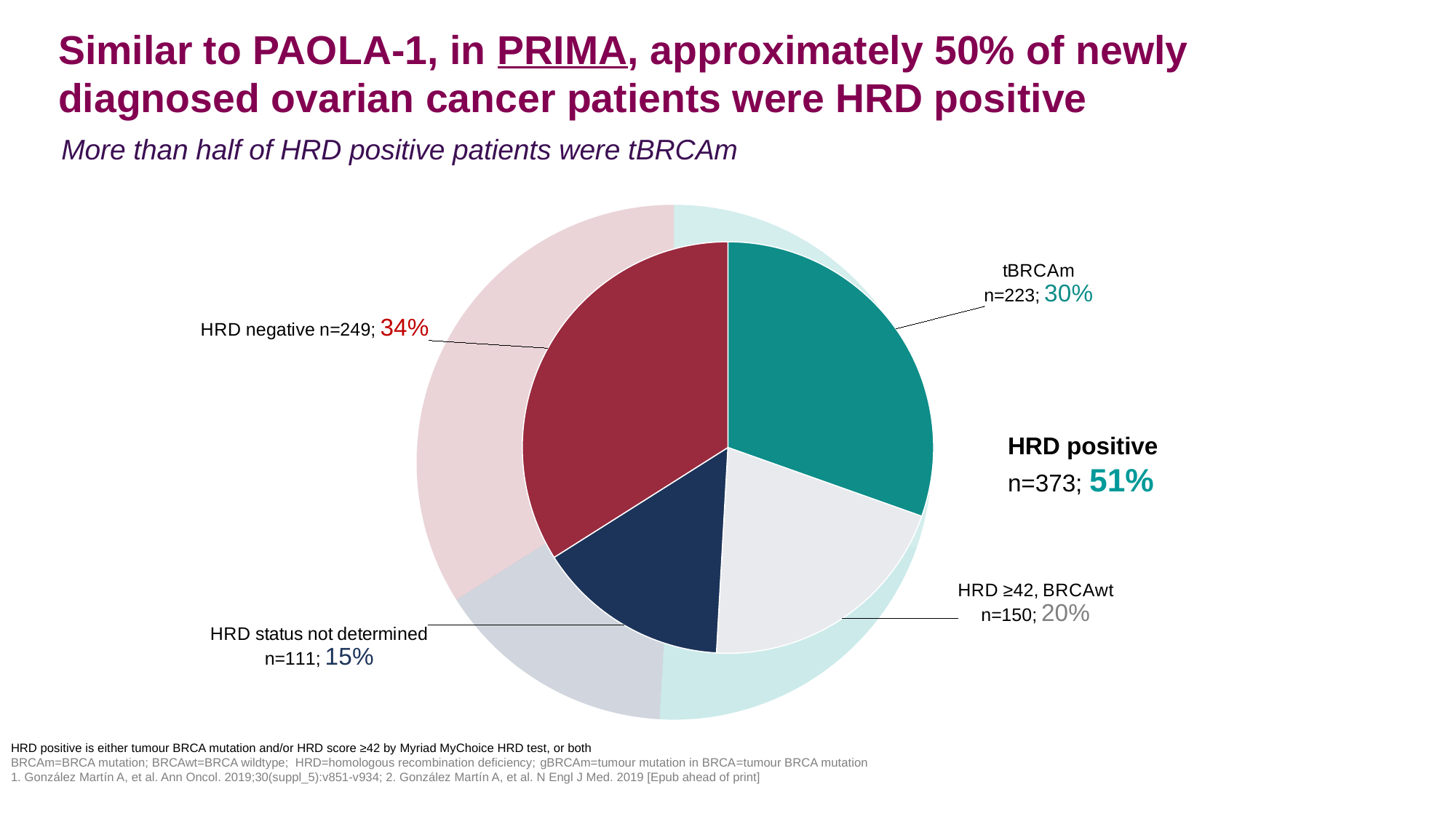
Which slice of the pie is the largest? HRD negative What is the combined percentage for HRD positive patients? 51% How many patients were in the HRD ≥42, BRCAwt group? n=150 How many patients were HRD negative? n=249 What percentage of patients had HRD status not determined? 15% What is the difference in percentage points between the HRD negative and tBRCAm slices? 4% What is the total number of patients in the two slices that make up HRD positive (tBRCAm and HRD ≥42, BRCAwt)? 373 Which is larger, the tBRCAm slice or the HRD ≥42, BRCAwt slice? tBRCAm What type of chart is shown on the slide? pie chart What percentage of patients were tBRCAm? 30% Which slice of the pie is the smallest? HRD status not determined How many slices does the pie chart have? 4